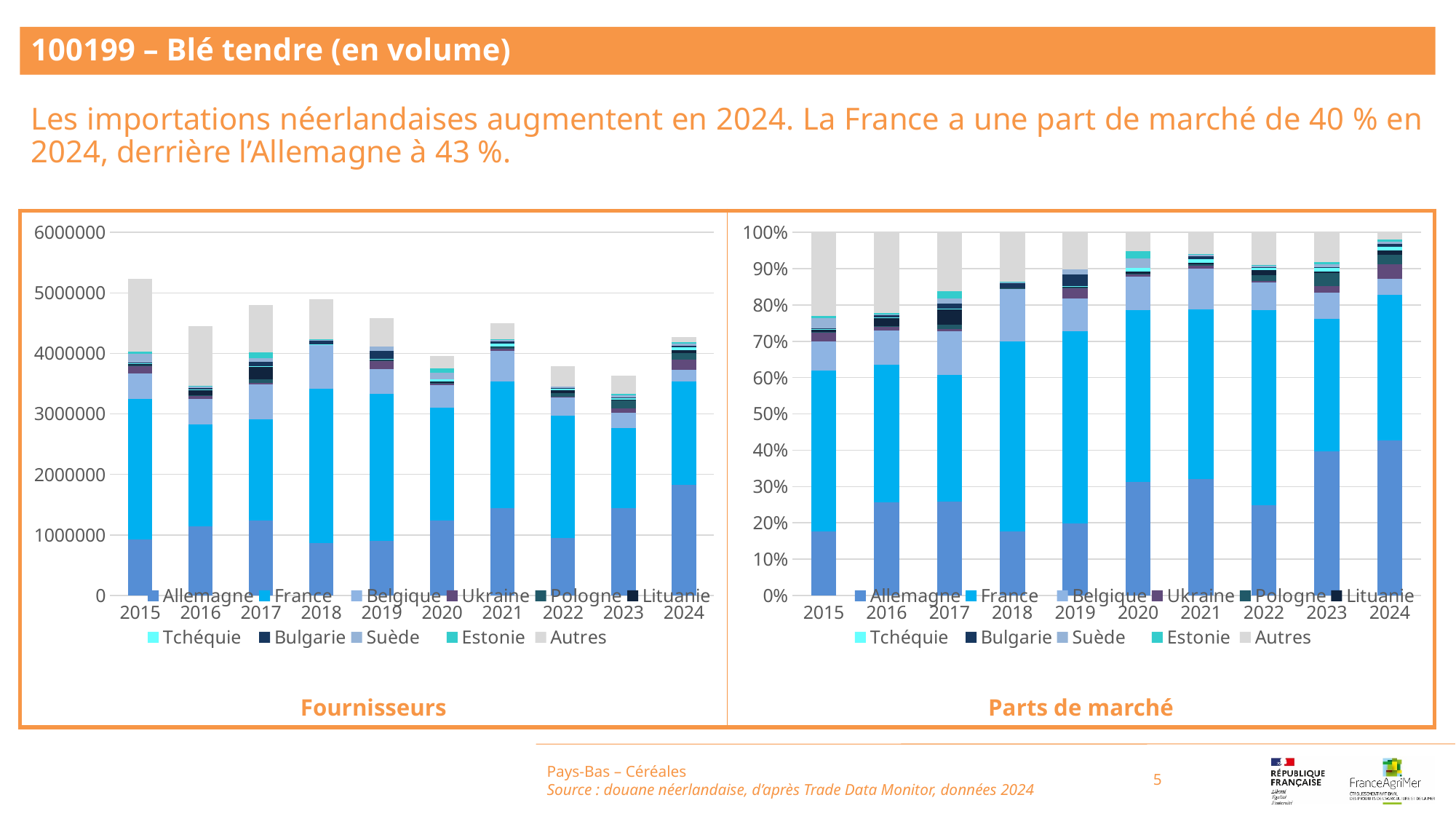
In the "Fournisseurs" chart, is the total bar for 2015 greater or less than 5000000? greater In the "Fournisseurs" chart, is the Allemagne segment larger in 2015 or in 2024? 2024 What is the title of the chart on the right side of the slide? Parts de marché In the "Parts de marché" chart, does the Allemagne share generally rise or fall from 2015 to 2024? rise How many years are shown on the x axis of the "Parts de marché" chart? 10 How many series does the legend of the "Fournisseurs" chart list? 11 In the "Fournisseurs" chart, is the Allemagne segment for 2024 greater or less than 1000000? greater In the "Parts de marché" chart, is the Allemagne share for 2015 greater or less than 20%? less What kind of chart is the "Fournisseurs" chart on the left? Stacked bar chart In the "Fournisseurs" chart, which year has the highest total bar? 2015